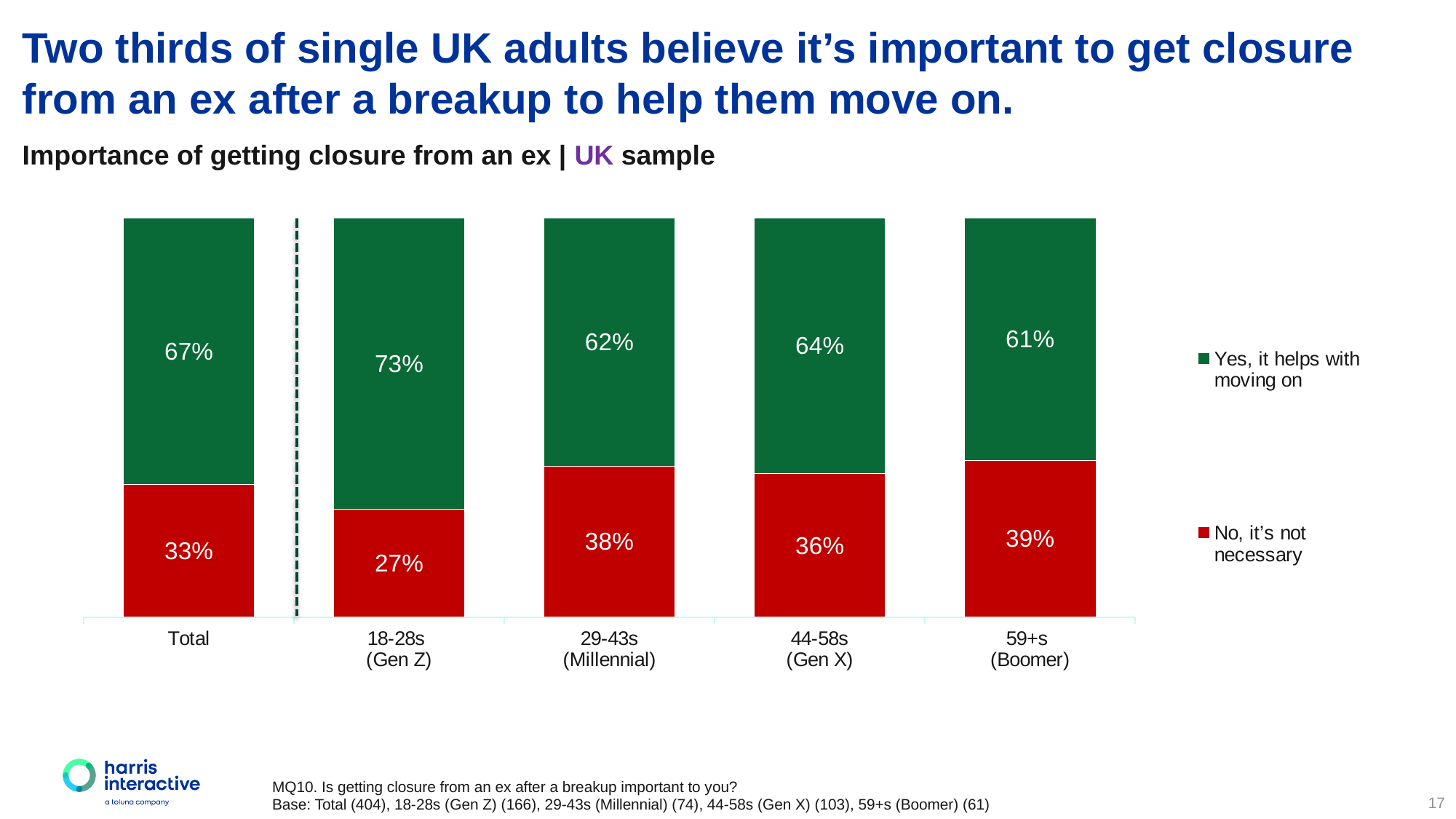
What kind of chart is shown on the slide? Stacked bar chart What is the 'Yes, it helps with moving on' value for 29-43s (Millennial)? 62% What percentage of the Total group said 'Yes, it helps with moving on'? 67% Which colour represents 'No, it's not necessary' in the chart? Red Which age group has the highest 'Yes, it helps with moving on' percentage? 18-28s (Gen Z) Which age group has the lowest 'Yes, it helps with moving on' percentage? 59+s (Boomer) Which is larger: the 'No, it's not necessary' value for 29-43s (Millennial) or for 44-58s (Gen X)? 29-43s (Millennial) How many series does the legend list? 2 How many categories are shown on the x axis of the chart? 5 What percentage of 18-28s (Gen Z) said 'No, it's not necessary'? 27% What is the 'No, it's not necessary' value for 59+s (Boomer)? 39% What is the difference in percentage points between the 'Yes' value for 18-28s (Gen Z) and the 'Yes' value for 59+s (Boomer)? 12